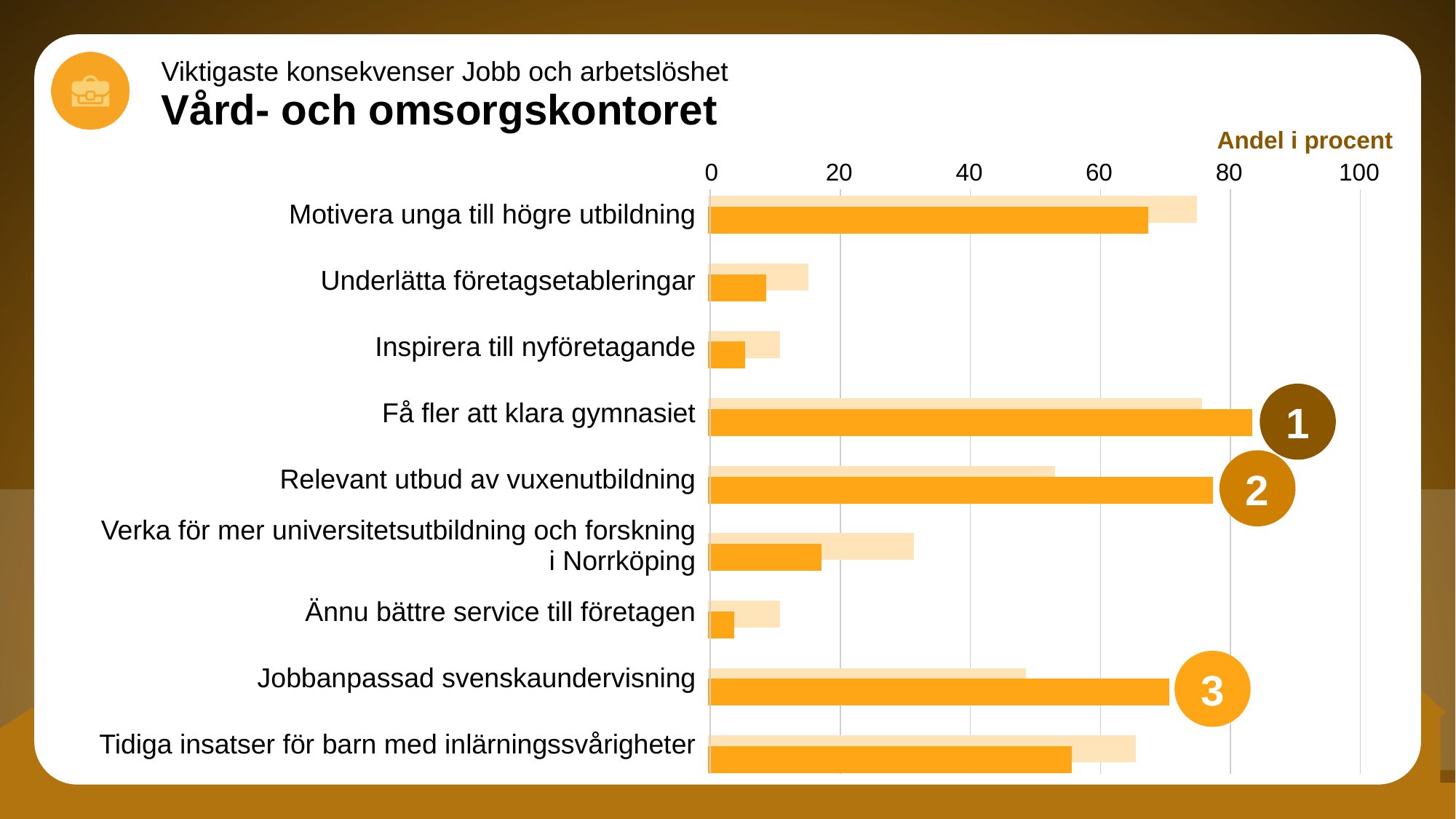
What kind of chart is shown on the slide? bar chart Which category has the longest dark orange bar? Få fler att klara gymnasiet How many categories are listed on the chart? 9 Is the dark orange bar for Underlätta företagsetableringar greater or less than 20? less Which category is marked with the circled number 3 on the chart? Jobbanpassad svenskaundervisning Which has a longer dark orange bar: Relevant utbud av vuxenutbildning or Verka för mer universitetsutbildning och forskning i Norrköping? Relevant utbud av vuxenutbildning Is the dark orange bar for Få fler att klara gymnasiet greater or less than 80? greater What label is shown above the horizontal axis of the chart? Andel i procent Is the light orange bar for Verka för mer universitetsutbildning och forskning i Norrköping greater or less than 20? greater Which has a longer dark orange bar: Jobbanpassad svenskaundervisning or Tidiga insatser för barn med inlärningssvårigheter? Jobbanpassad svenskaundervisning